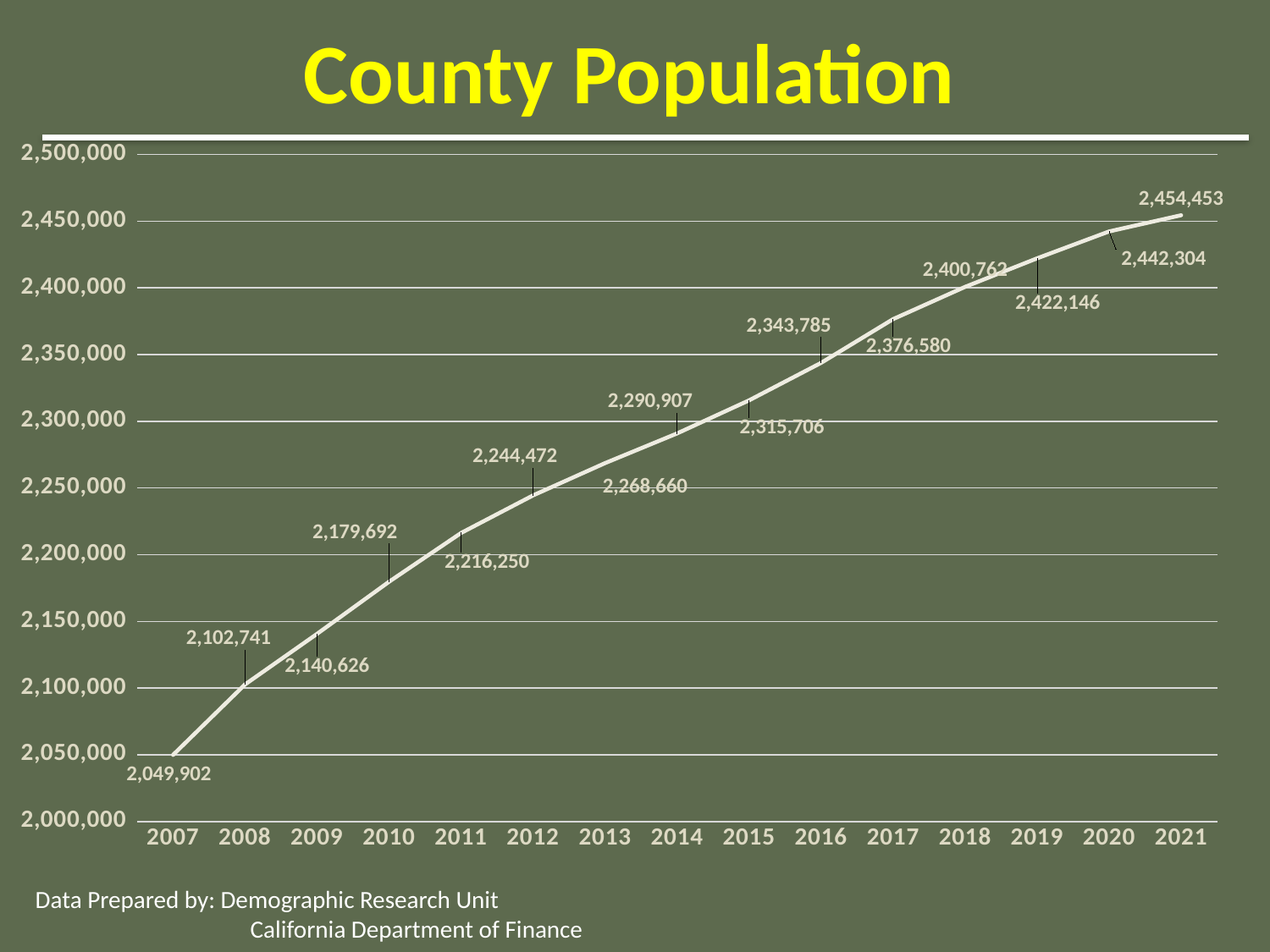
What kind of chart is shown on the slide? line chart How many years are plotted on the x axis? 15 Which year has the highest county population? 2021 Does the county population rise or fall from 2007 to 2021? rise What is the county population shown for 2014? 2,290,907 What is the county population shown for 2011? 2,216,250 What is the difference in county population between 2019 and 2020? 20,158 What is the county population shown for 2021? 2,454,453 By how much did the county population increase from 2007 to 2021? 404,551 Is the county population in 2016 greater or less than 2,350,000? less What is the county population shown for 2007? 2,049,902 Which year has the lowest county population? 2007